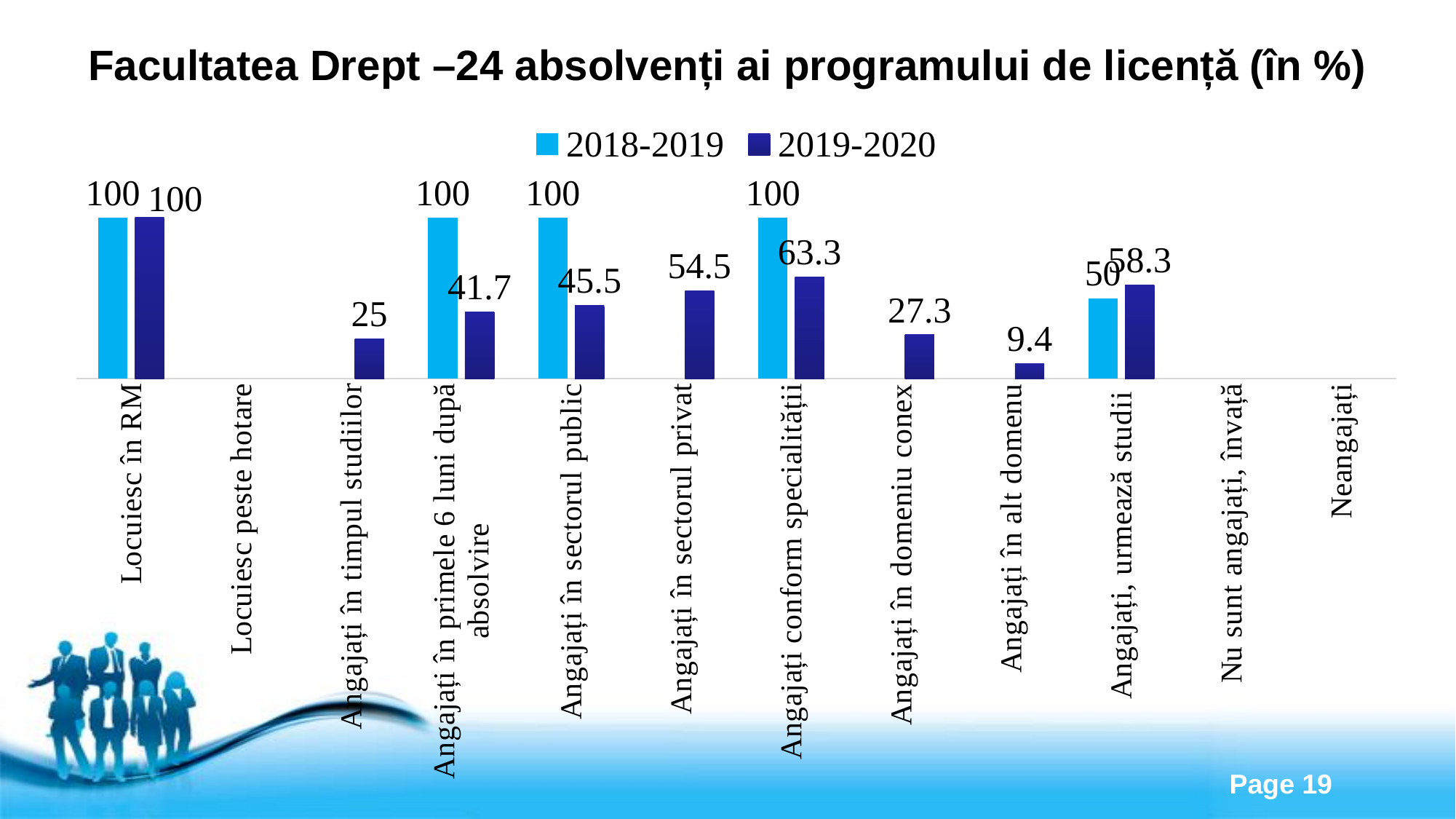
What is the difference between the 2018-2019 and 2019-2020 values for "Angajați conform specialității"? 36.7 Which category has the lowest 2019-2020 value among those with a labelled bar? Angajați în alt domenu How many categories are shown on the x axis? 12 What is the 2019-2020 value for "Angajați în timpul studiilor"? 25 What is the 2019-2020 value for "Angajați în alt domenu"? 9.4 What is the 2019-2020 value for "Angajați în sectorul privat"? 54.5 What is the 2019-2020 value for "Angajați în primele 6 luni după absolvire"? 41.7 What kind of chart is shown on the slide? Bar chart What is the difference between the 2019-2020 values for "Angajați în sectorul privat" and "Angajați în sectorul public"? 9 What is the 2018-2019 value for "Angajați, urmează studii"? 50 How many series does the legend list? 2 Which is larger for "Angajați, urmează studii": the 2018-2019 value or the 2019-2020 value? 2019-2020